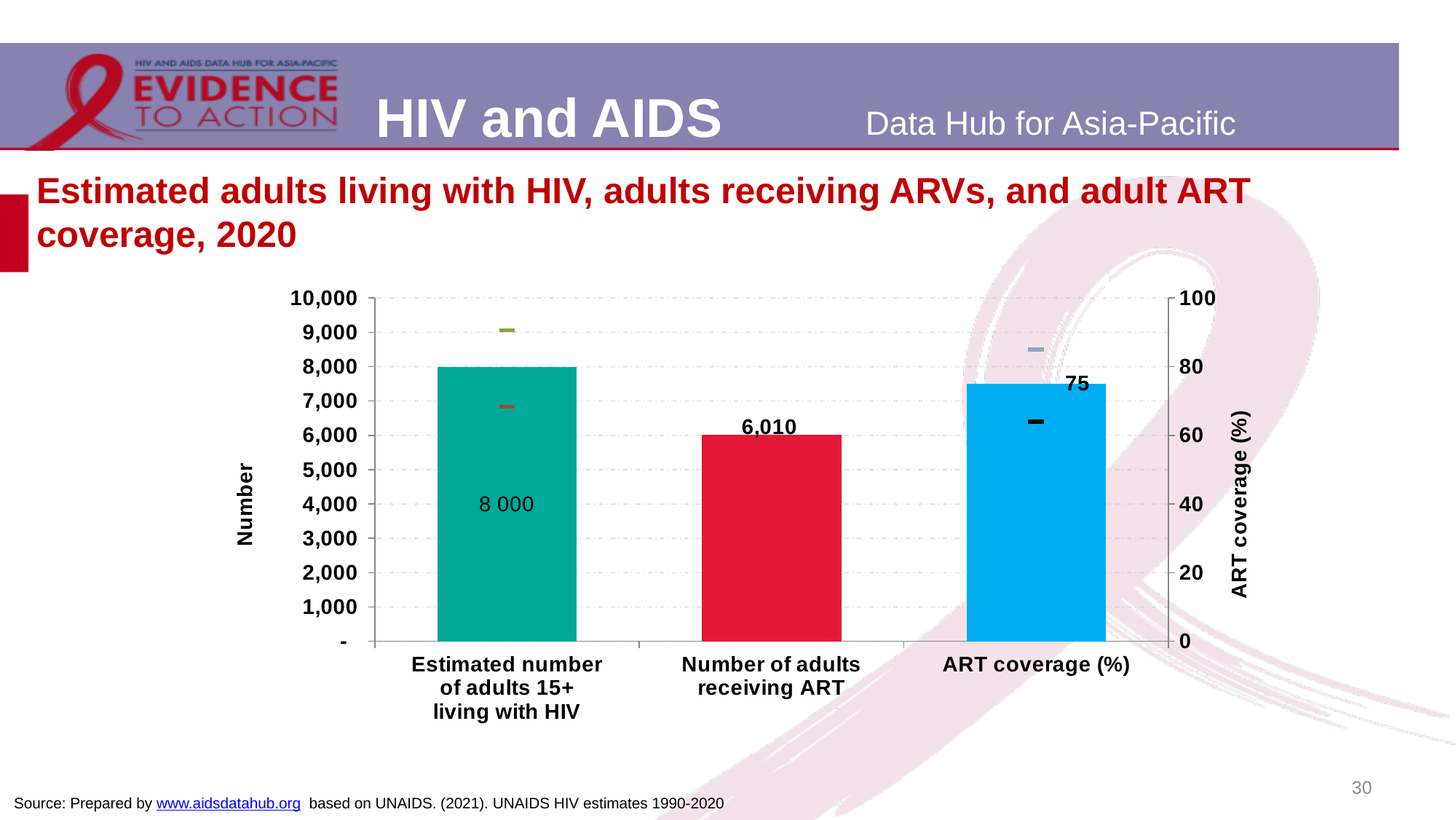
What is the estimated number of adults 15+ living with HIV shown on the chart? 8 000 What is the difference between the estimated number of adults 15+ living with HIV and the number of adults receiving ART? 1,990 Of the two bars plotted against the left 'Number' axis, which category has the lower value? Number of adults receiving ART What kind of chart is shown on the slide? Bar chart What is the ART coverage (%) value shown on the chart? 75 How many categories are shown on the x axis of the chart? 3 What is the number of adults receiving ART shown on the chart? 6,010 What is the label of the right vertical axis of the chart? ART coverage (%) What is the label of the left vertical axis of the chart? Number Is the number of adults receiving ART greater or less than 7,000? less Which is larger: the estimated number of adults 15+ living with HIV or the number of adults receiving ART? Estimated number of adults 15+ living with HIV Is the ART coverage (%) value greater or less than 60? greater